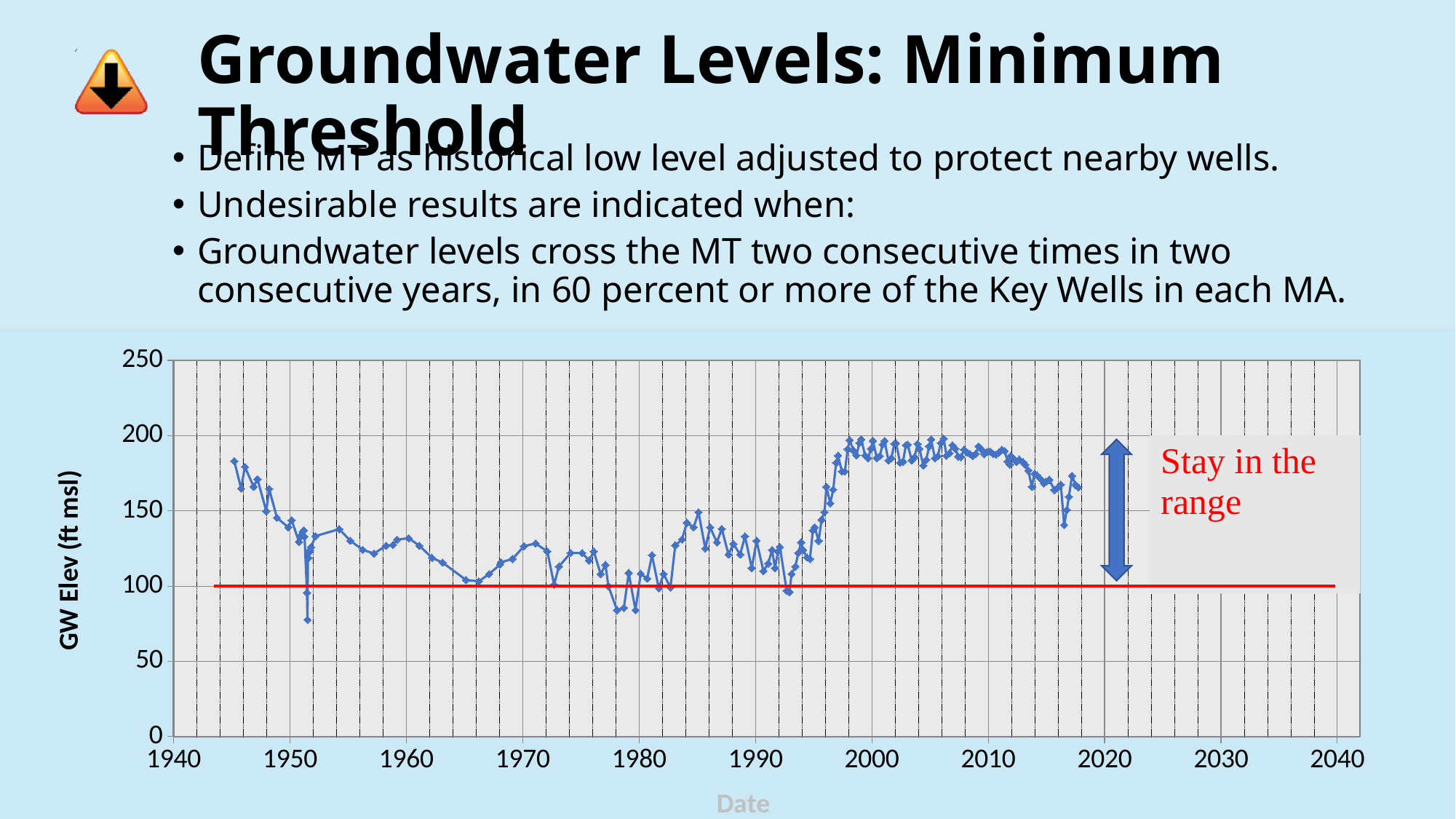
What kind of chart is shown on the slide? line chart What is the label of the vertical axis? GW Elev (ft msl) At what groundwater elevation is the red horizontal line drawn? 100 Is the groundwater elevation around 1978 greater or less than 100? less Is the groundwater elevation around the year 2000 greater or less than 150? greater What is the label of the horizontal axis? Date Do groundwater levels rise or fall between 1945 and 1951? fall Is the groundwater elevation around 2010 greater or less than 150? greater Do groundwater levels rise or fall between 1993 and 1998? rise Is the groundwater elevation around 2000 higher or lower than around 1965? higher What is the highest value shown on the vertical axis? 250